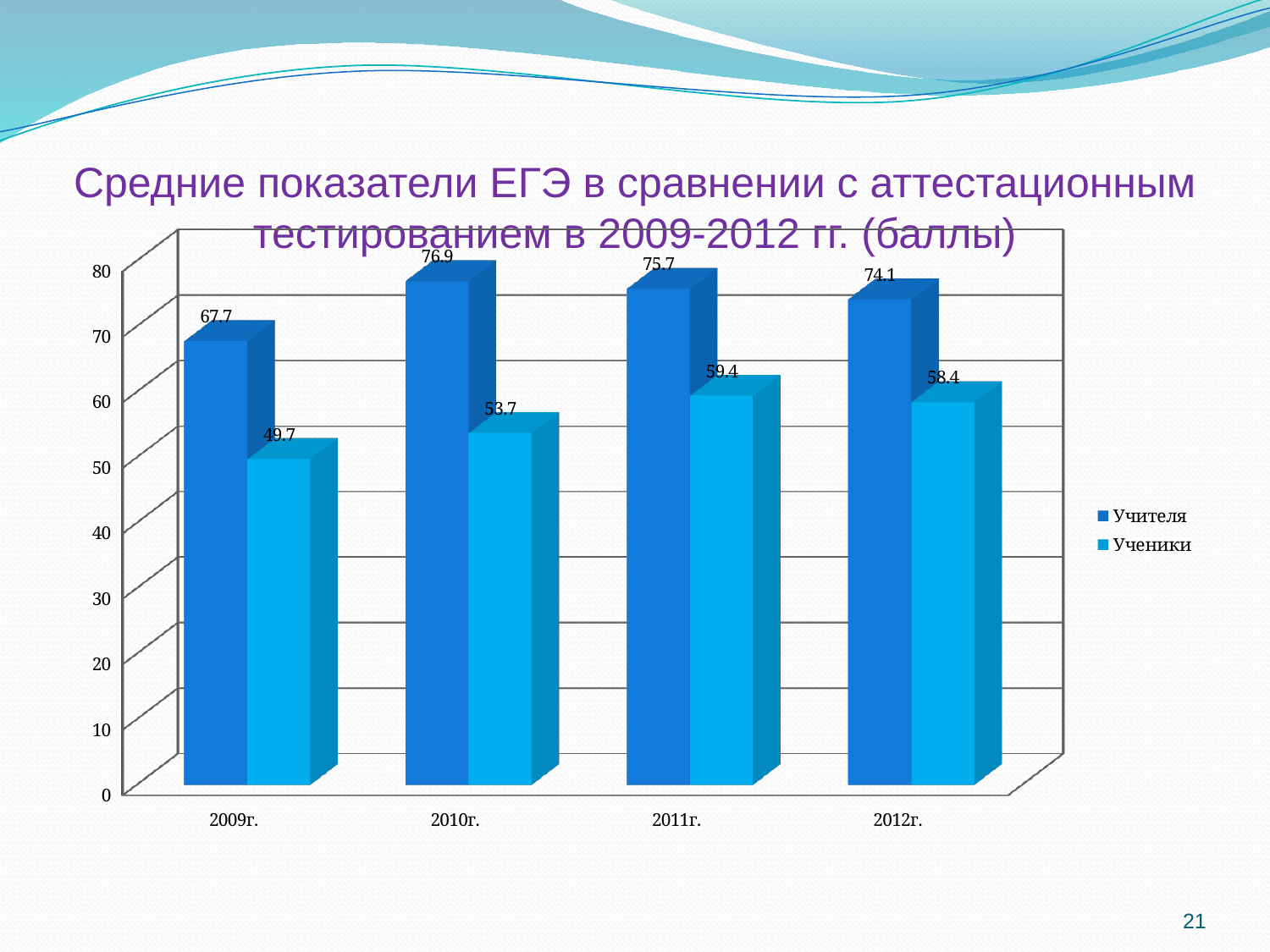
What is the value for Учителя in 2012г.? 74.1 In which year is the value for Ученики the lowest? 2009г. What is the value for Учителя in 2010г.? 76.9 Which is larger in 2012г.: the value for Учителя or for Ученики? Учителя Does the value for Ученики rise or fall from 2009г. to 2011г.? Rise In which year is the value for Учителя the highest? 2010г. What is the value for Ученики in 2011г.? 59.4 How many series does the legend list? 2 What is the difference between the Учителя and Ученики values in 2009г.? 18 What is the value for Ученики in 2009г.? 49.7 How many years are shown on the x axis? 4 What kind of chart is shown on the slide? Bar chart